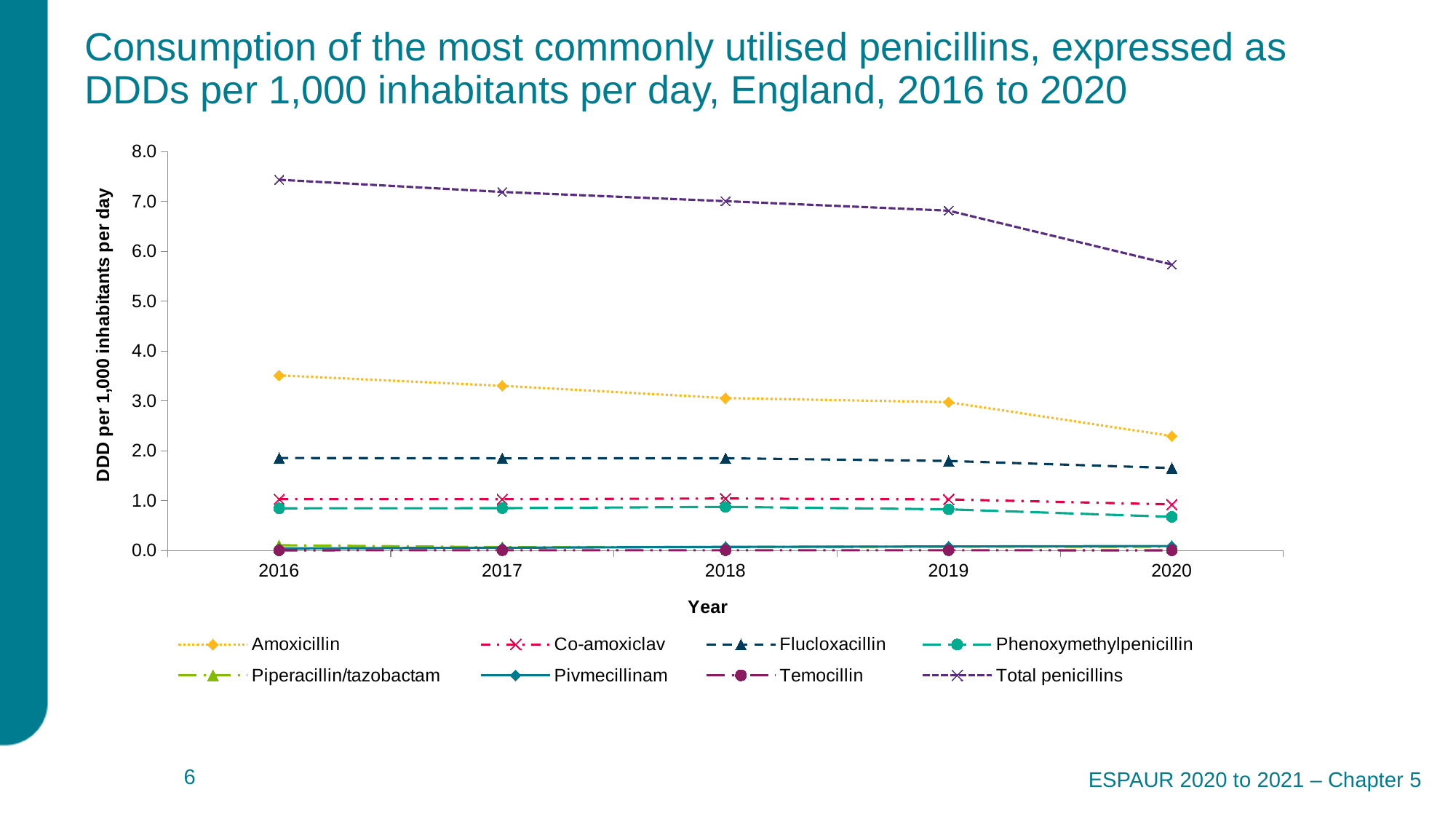
In 2018, which is larger: Flucloxacillin or Co-amoxiclav? Flucloxacillin Which series has the highest value in 2016? Total penicillins Is the value for Total penicillins in 2016 greater or less than 7.0? greater How many years are plotted along the x axis? 5 Is the value for Total penicillins in 2020 greater or less than 6.0? less Is the value for Amoxicillin in 2020 greater or less than 3.0? less How many series does the legend list? 8 What kind of chart is shown on the slide? line chart Does the Total penicillins line rise or fall from 2016 to 2020? fall Does the Amoxicillin line rise or fall from 2016 to 2020? fall What is the title of the x axis? Year